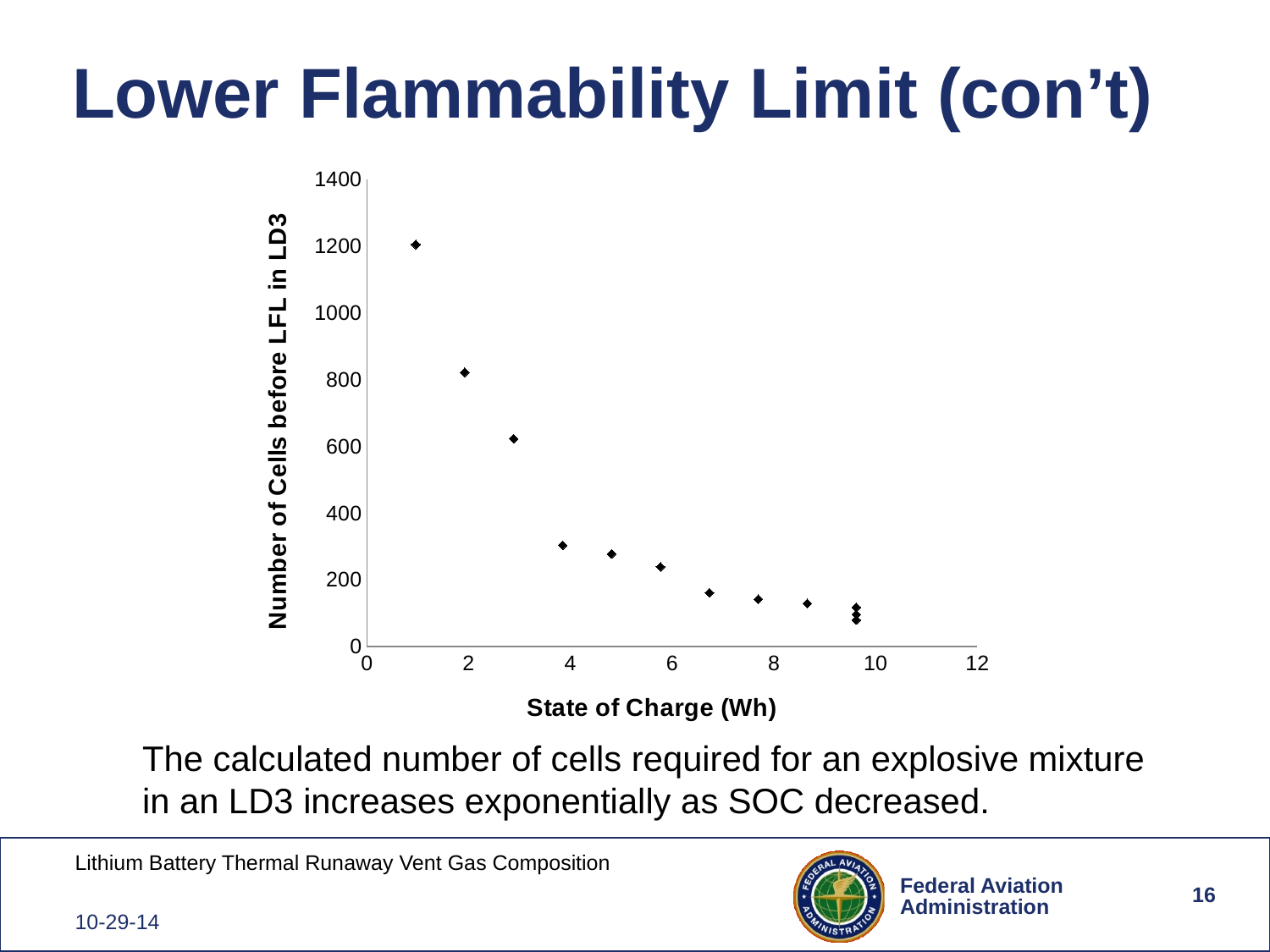
Is the Number of Cells before LFL at a State of Charge of about 2 Wh greater or less than 1000? less Is the Number of Cells before LFL at a State of Charge of about 7 Wh greater or less than 200? less Is the Number of Cells before LFL at a State of Charge of about 1 Wh greater or less than 1000? greater What is the label of the x axis? State of Charge (Wh) What is the label of the y axis? Number of Cells before LFL in LD3 What kind of chart is shown on the slide? scatter chart What is the highest value shown on the y axis? 1400 As State of Charge increases along the x axis, does the Number of Cells before LFL rise or fall? fall Which has the larger Number of Cells before LFL: the point at about 1 Wh or the point at about 2 Wh? the point at about 1 Wh